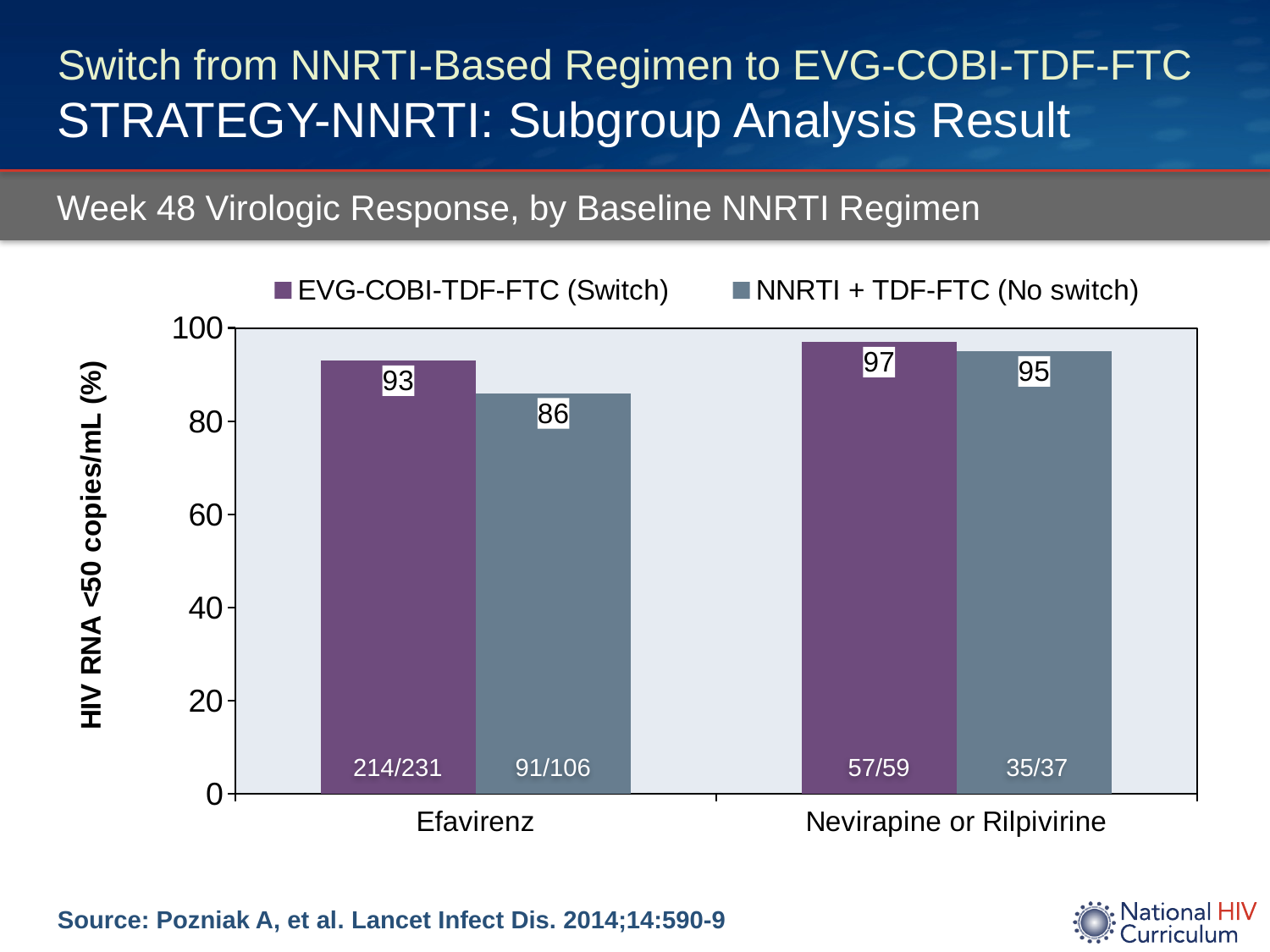
How many series does the legend list? 2 Which bar has the lowest value on the chart? NNRTI + TDF-FTC (No switch), Efavirenz What is the value for NNRTI + TDF-FTC (No switch) in the Nevirapine or Rilpivirine group? 95 What kind of chart is shown on the slide? Bar chart How many baseline NNRTI regimen categories are shown on the x axis? 2 What is the difference between the Switch and No switch values in the Nevirapine or Rilpivirine group? 2 In the Efavirenz group, which series has the larger value: EVG-COBI-TDF-FTC (Switch) or NNRTI + TDF-FTC (No switch)? EVG-COBI-TDF-FTC (Switch) What is the value for EVG-COBI-TDF-FTC (Switch) in the Nevirapine or Rilpivirine group? 97 What is the value for EVG-COBI-TDF-FTC (Switch) in the Efavirenz group? 93 Which bar has the highest value on the chart? EVG-COBI-TDF-FTC (Switch), Nevirapine or Rilpivirine What is the difference between the Switch and No switch values in the Efavirenz group? 7 What is the value for NNRTI + TDF-FTC (No switch) in the Efavirenz group? 86